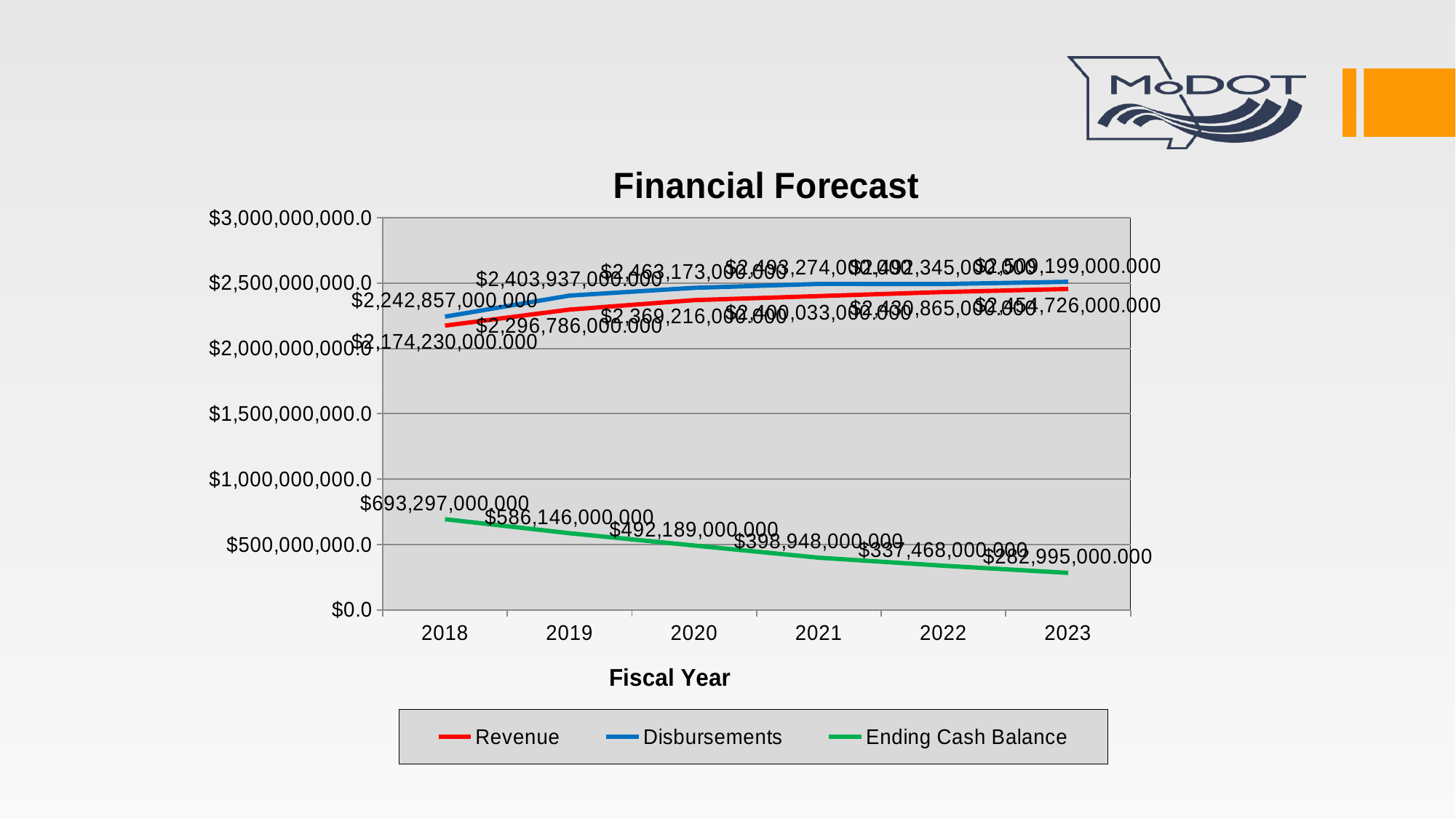
What is the difference between the Ending Cash Balance in 2018 and in 2019? $107,151,000.000 In which fiscal year is the Ending Cash Balance highest? 2018 What kind of chart is shown on the slide? line chart What is the Ending Cash Balance for fiscal year 2023? $282,995,000.000 What is the Ending Cash Balance for fiscal year 2018? $693,297,000.000 In fiscal year 2018, which is larger, Revenue or Disbursements? Disbursements In which fiscal year is the Ending Cash Balance lowest? 2023 What is the title of the x axis on the chart? Fiscal Year How many fiscal years are plotted on the x axis of the Financial Forecast chart? 6 What is the Revenue value for fiscal year 2018? $2,174,230,000.000 Does the Ending Cash Balance rise or fall from 2018 to 2023? fall How many series does the legend of the Financial Forecast chart list? 3